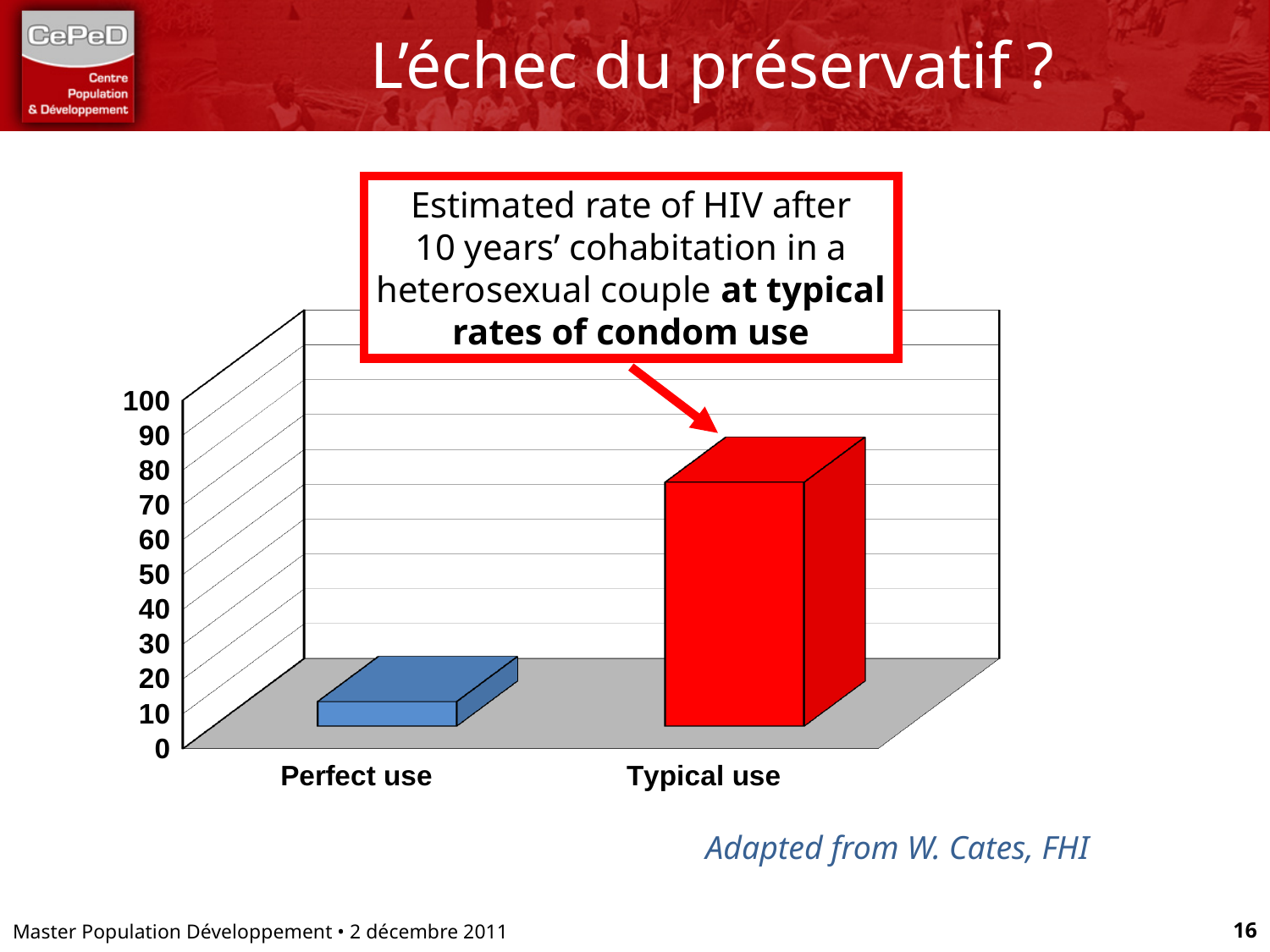
Is the value for Typical use greater or less than 60? greater Which is larger, the value for Perfect use or the value for Typical use? Typical use Is the value for Perfect use greater or less than 30? less Is the value for Perfect use greater or less than 20? less What kind of chart is shown on the slide? bar chart Which category has the highest bar in the chart? Typical use Which category has the lowest bar in the chart? Perfect use How many categories are plotted on the x axis of the chart? 2 What is the highest value shown on the vertical axis of the chart? 100 What colour is the bar for Typical use? red Do the values rise or fall moving from Perfect use to Typical use along the x axis? rise